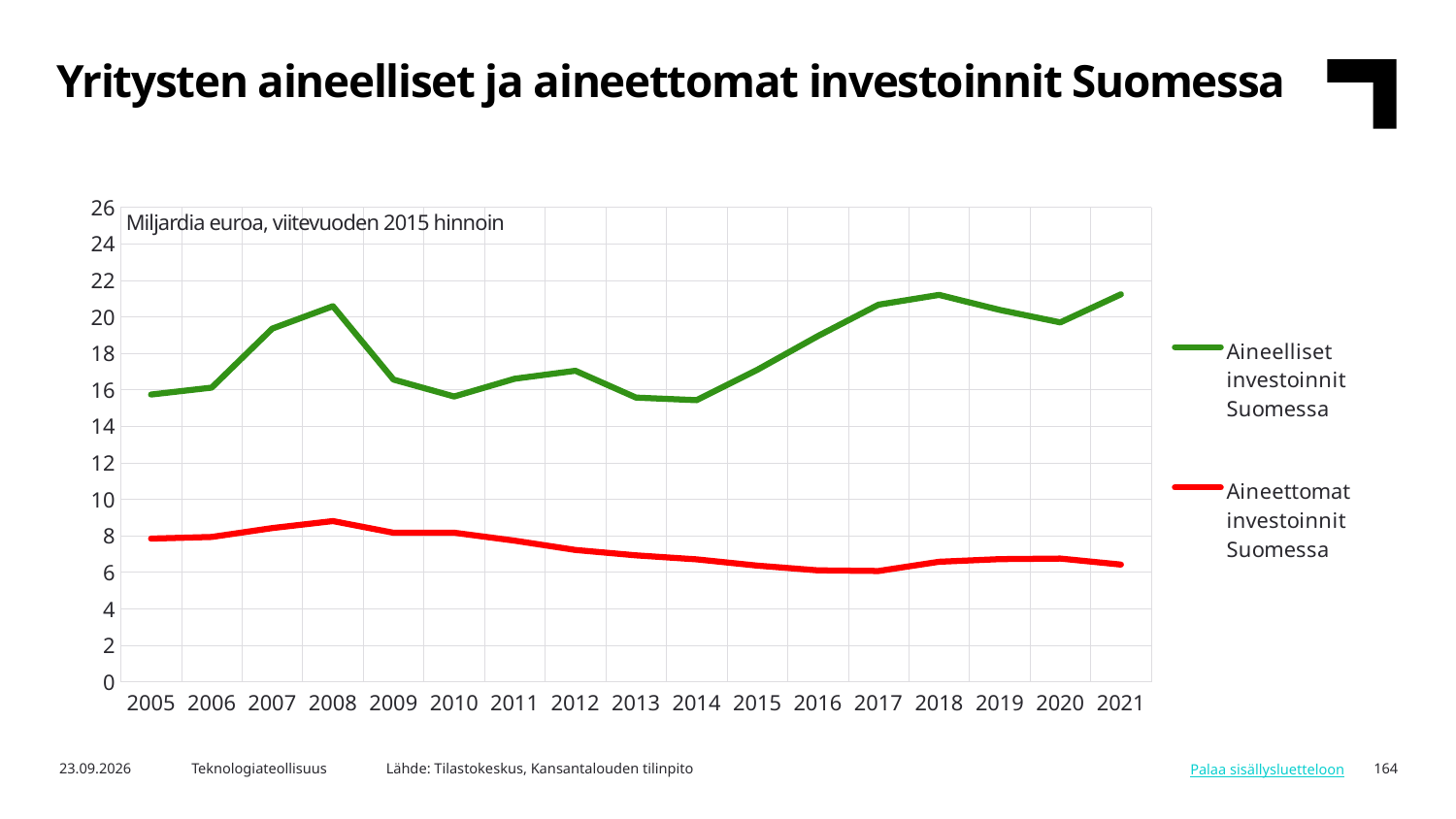
Is the value for Aineelliset investoinnit Suomessa in 2014 greater or less than 16? less Is the value for Aineettomat investoinnit Suomessa in 2017 greater or less than 8? less What unit is stated inside the chart area? Miljardia euroa, viitevuoden 2015 hinnoin Which series has the larger value in 2010, Aineelliset investoinnit Suomessa or Aineettomat investoinnit Suomessa? Aineelliset investoinnit Suomessa In which year is the value for Aineettomat investoinnit Suomessa highest? 2008 How many years are shown on the x axis? 17 Is the value for Aineelliset investoinnit Suomessa in 2008 greater or less than 20? greater What is the title of the chart? Yritysten aineelliset ja aineettomat investoinnit Suomessa How many series does the legend list? 2 Does the value for Aineelliset investoinnit Suomessa rise or fall from 2014 to 2018? rise What kind of chart is shown on the slide? line chart Does the value for Aineettomat investoinnit Suomessa rise or fall from 2008 to 2016? fall